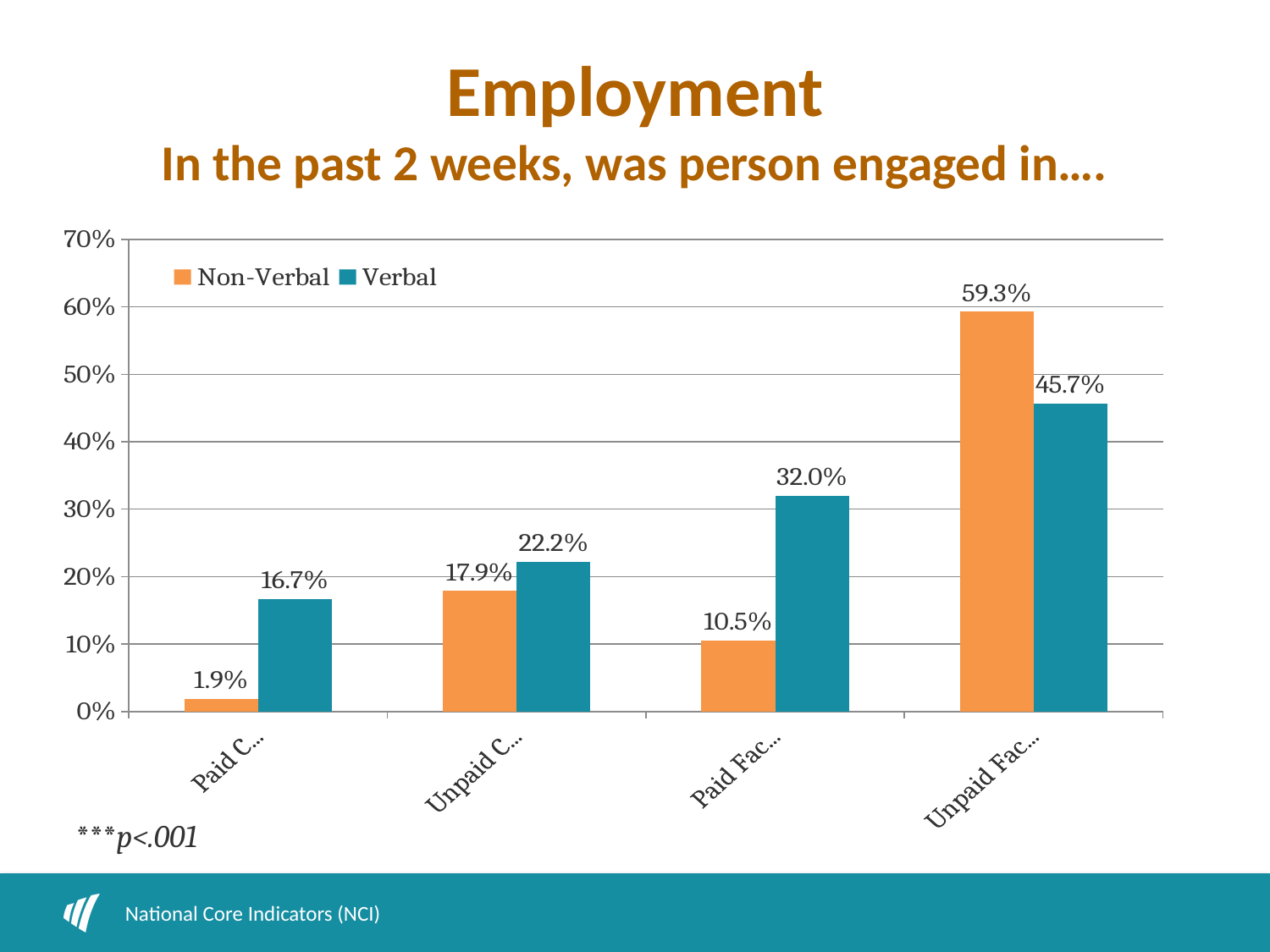
Which category has the highest Verbal value? the fourth category (Unpaid Fac…) How many categories are shown on the x axis? 4 What is the difference between the Verbal and Non-Verbal values for the second category from the left (labelled "Unpaid C…")? 4.3% Is the Verbal value for the first category from the left (labelled "Paid C…") greater or less than 20%? less What is the Non-Verbal value for the first category from the left (labelled "Paid C…")? 1.9% Which series is shown in orange in the legend? Non-Verbal What type of chart is shown on the slide? bar chart What is the Verbal value for the third category from the left (labelled "Paid Fac…")? 32.0% For the fourth category from the left (labelled "Unpaid Fac…"), which is larger, the Non-Verbal value or the Verbal value? Non-Verbal How many series does the legend list? 2 Which category has the lowest Non-Verbal value? the first category (Paid C…) What is the Non-Verbal value for the fourth category from the left (labelled "Unpaid Fac…")? 59.3%